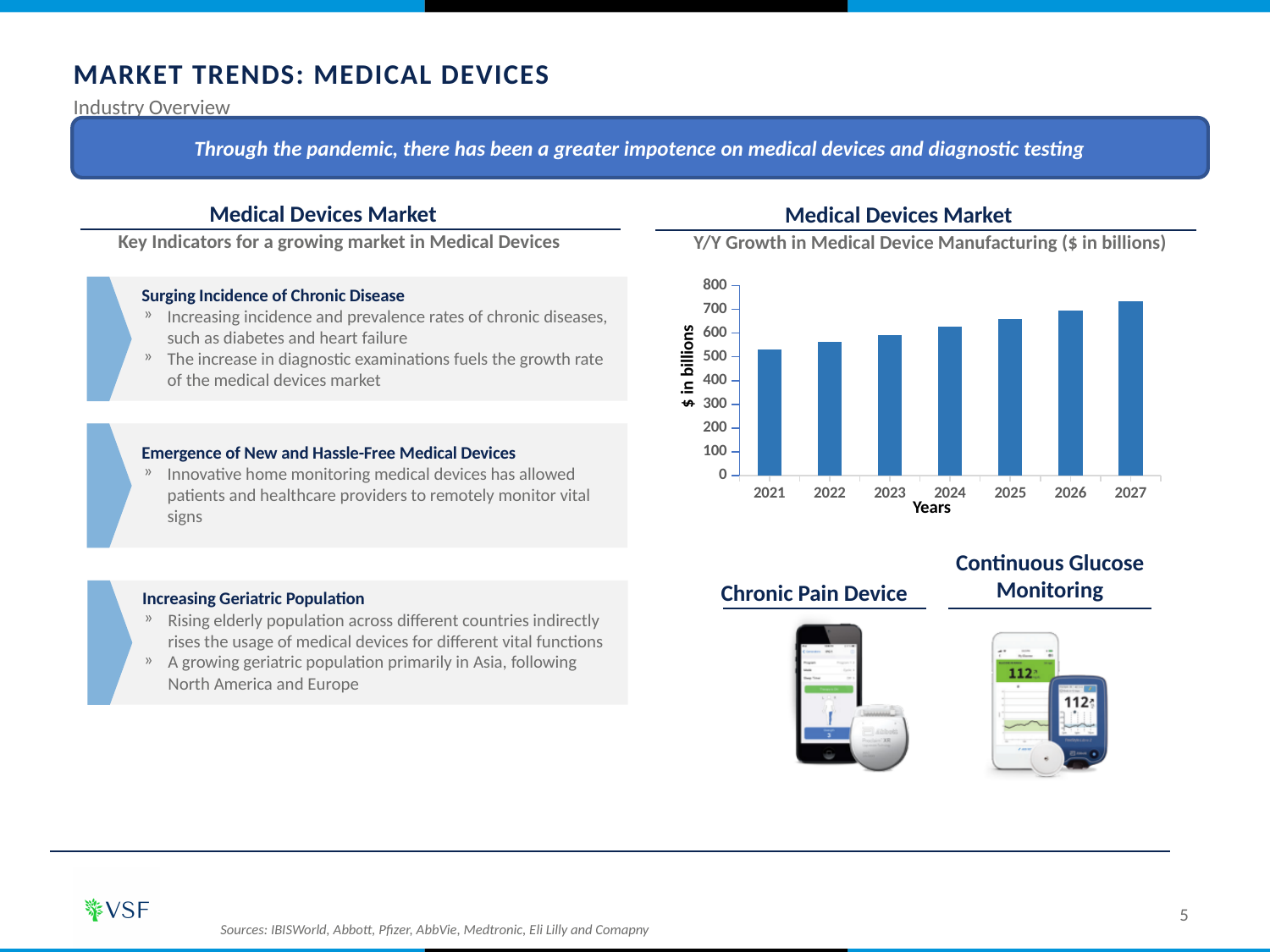
Is the value for 2025 in the bar chart greater or less than 700? less Which year has the lowest bar in the chart? 2021 What is the label on the x axis of the bar chart? Years How many years are plotted on the x axis of the bar chart? 7 Is the value for 2027 in the bar chart greater or less than 700? greater Which year has the highest bar in the chart? 2027 What kind of chart is shown under the title "Y/Y Growth in Medical Device Manufacturing ($ in billions)"? bar chart Do the values in the bar chart rise or fall from 2021 to 2027? rise Which year has the larger value in the bar chart, 2023 or 2026? 2026 Is the value for 2021 in the bar chart greater or less than 600? less What is the label on the y axis of the bar chart? $ in billions